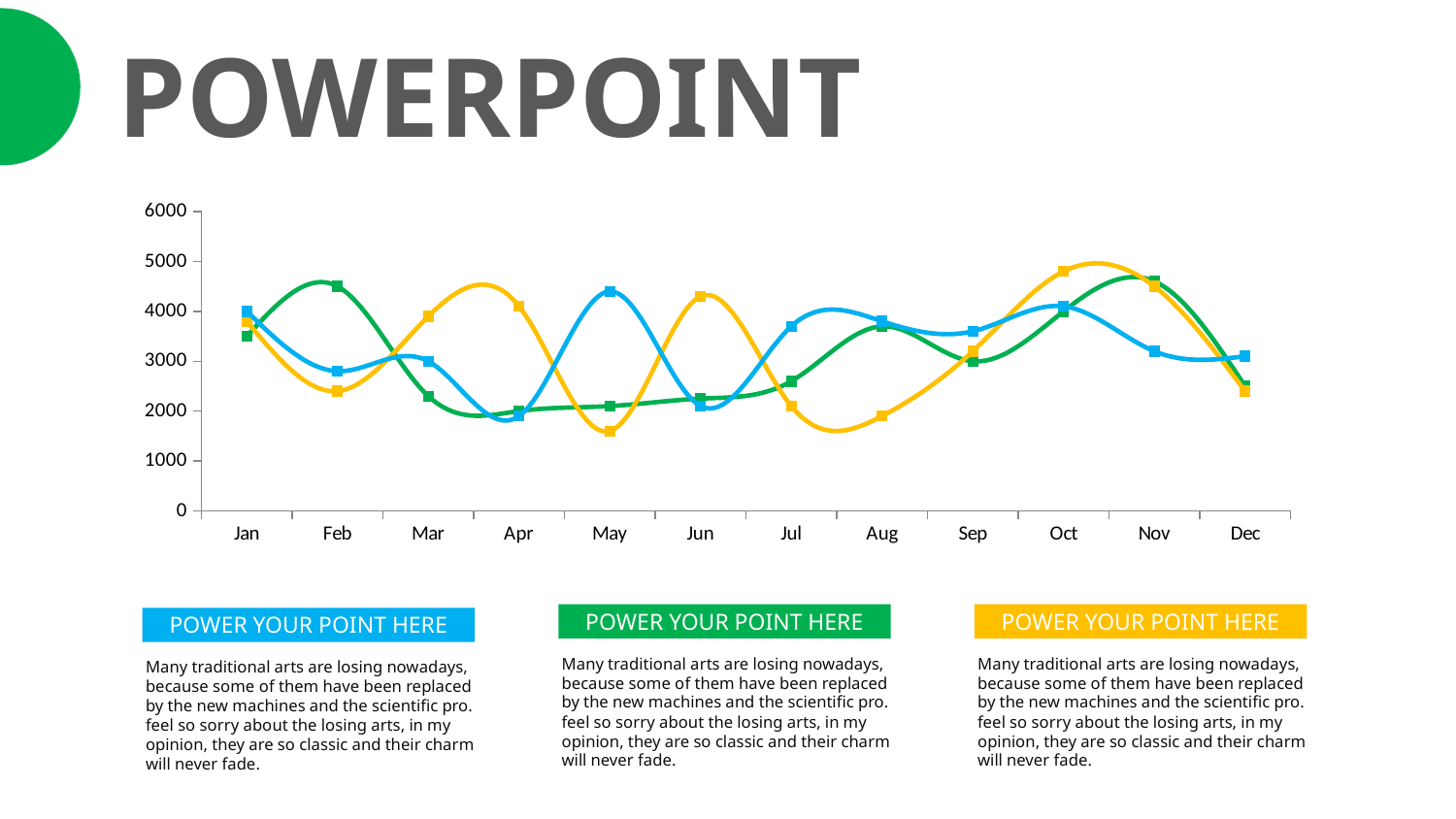
In which month does the yellow line reach its lowest value? May Is the value of the yellow line in Oct greater or less than 4000? greater Is the value of the green line in Feb greater or less than 4000? greater How many categories are shown on the x axis of the chart? 12 In which month does the yellow line reach its highest value? Oct Is the value of the yellow line in May greater or less than 2000? less How many lines (series) are plotted on the chart? 3 What kind of chart is shown on the slide? line chart In Feb, which line has the higher value, the green line or the yellow line? green line What is the highest value shown on the y axis of the chart? 6000